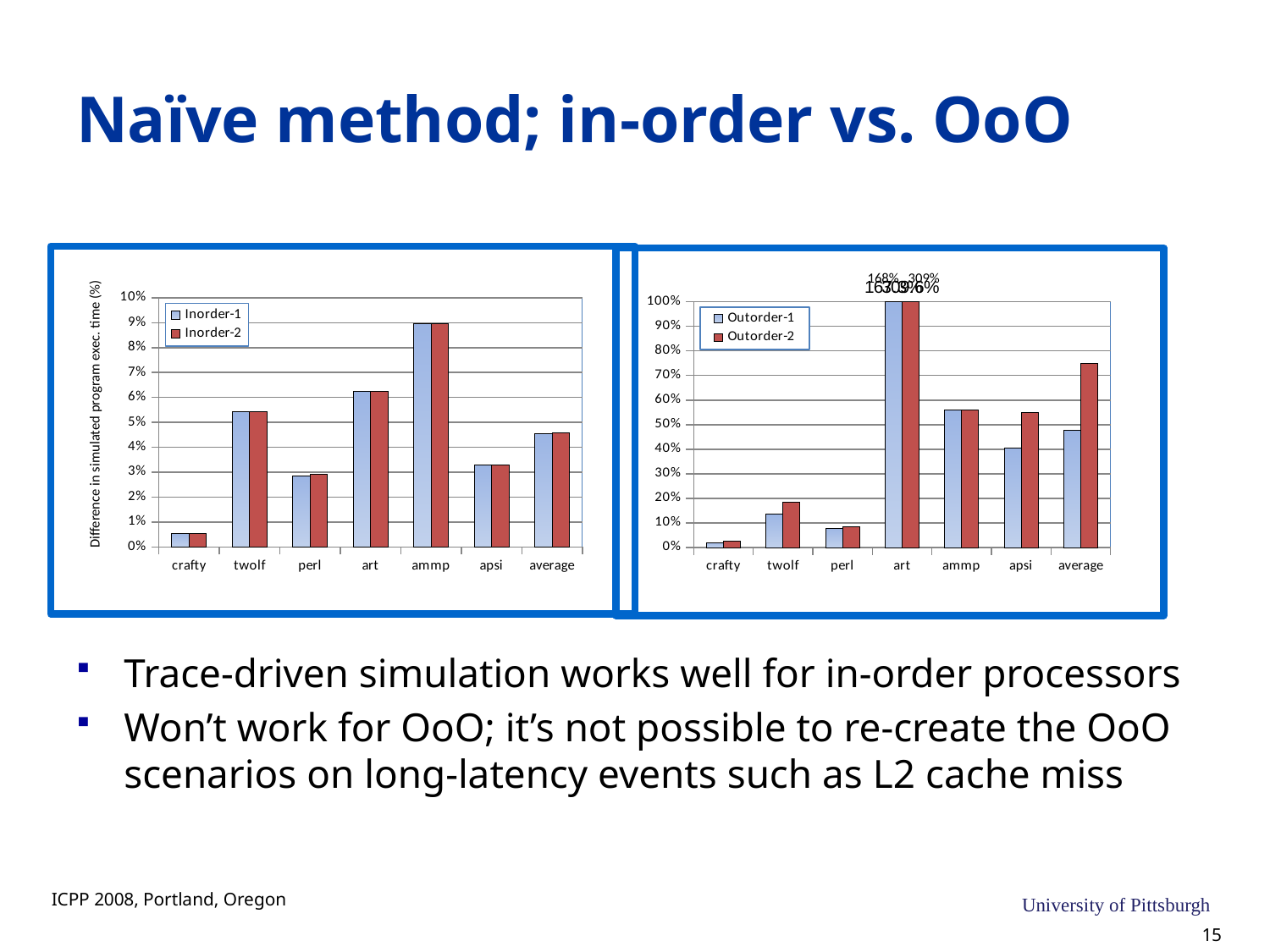
In the left chart, which category has the lowest bars? crafty How many categories are shown on the x axis of the right chart? 7 In the right chart, is the Outorder-2 value for average greater or less than 70%? greater In the left chart, is the Inorder-1 value for ammp greater or less than 8%? greater In the right chart, which category has the lowest bars? crafty In the left chart, is the Inorder-2 value for crafty greater or less than 1%? less In the right chart, which category has the highest bars? art In the left chart, which category has the highest bars? ammp In the right chart, for apsi, which series has the larger value, Outorder-1 or Outorder-2? Outorder-2 What kind of chart is the left chart on the slide? bar chart How many series does the legend of the left chart list? 2